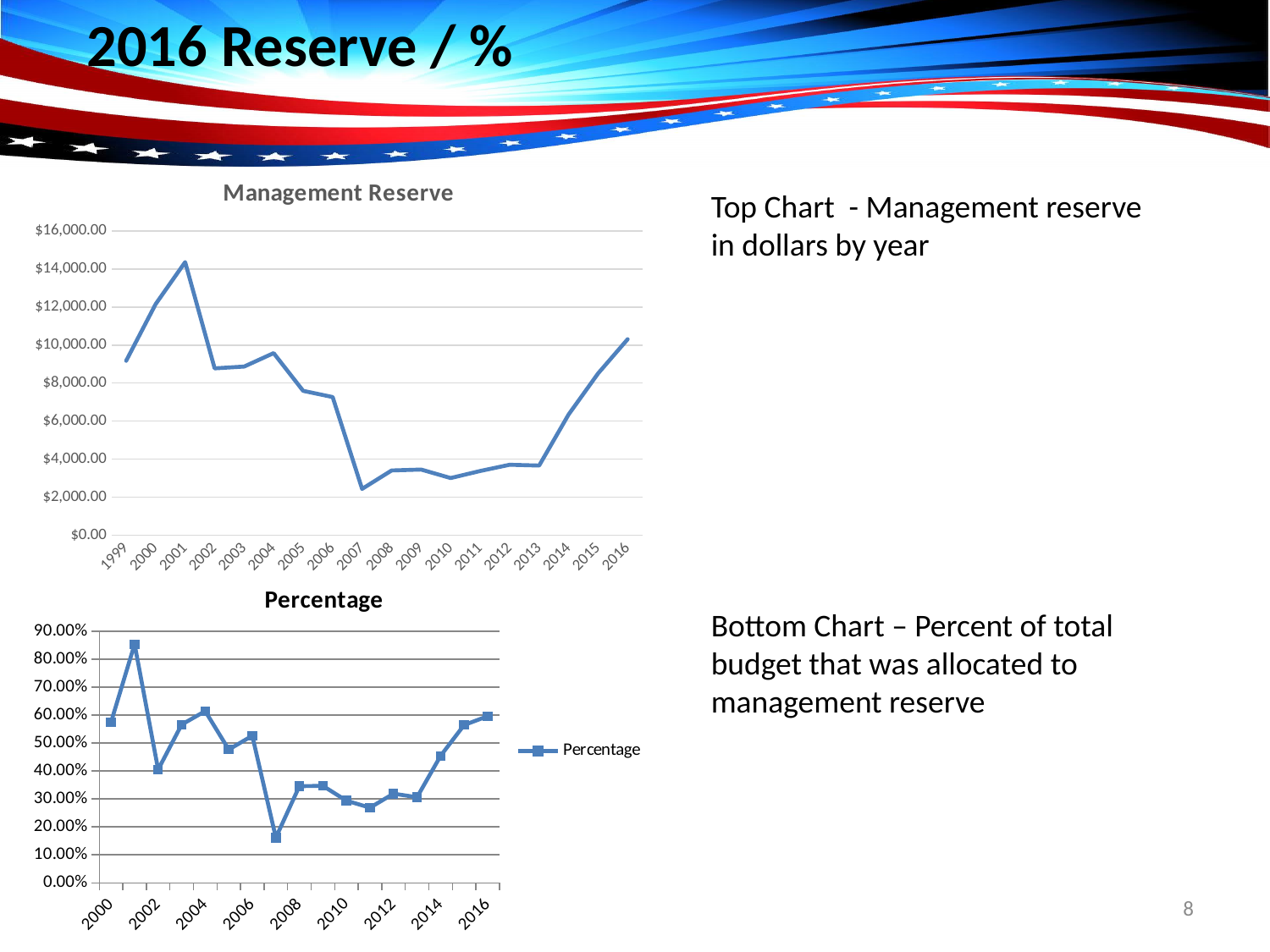
How many years are plotted on the x axis of the top chart "Management Reserve"? 18 In the top chart "Management Reserve", which year has the lowest value? 2007 In the top chart "Management Reserve", is the value for 2007 greater or less than $4,000.00? less In the bottom chart "Percentage", which year has the lowest value? 2007 In the top chart "Management Reserve", do the values rise or fall from 2013 to 2016? rise How many series does the legend of the bottom chart "Percentage" list? 1 What kind of chart is the top chart titled "Management Reserve"? line chart In the top chart "Management Reserve", is the value for 2016 greater or less than $8,000.00? greater In the top chart "Management Reserve", which year has the highest value? 2001 In the top chart "Management Reserve", which year has the larger value, 2001 or 2016? 2001 In the bottom chart "Percentage", is the value for 2007 greater or less than 20.00%? less In the bottom chart "Percentage", which year has the highest value? 2001